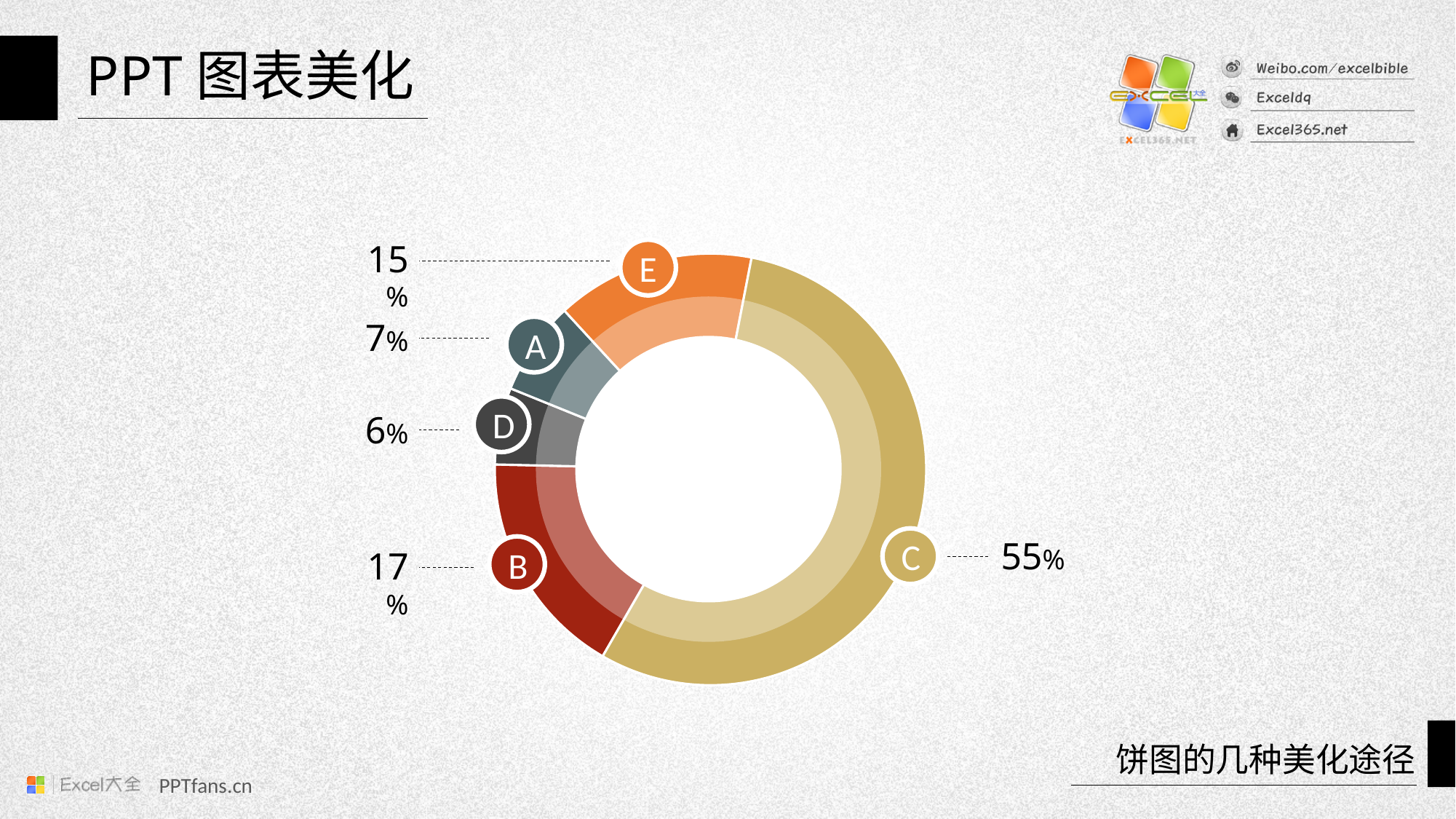
What is the value for segment E? 15% Which segment has the largest share? C What colour is segment C? Gold/tan Which is larger, the value for E or the value for A? E What is the value for segment B? 17% What kind of chart is shown on the slide? Donut (pie) chart What is the value for segment C? 55% How many segments does the chart have? 5 What is the value for segment A? 7% Which segment has the smallest share? D What is the value for segment D? 6% What is the difference between the values for C and B? 38%